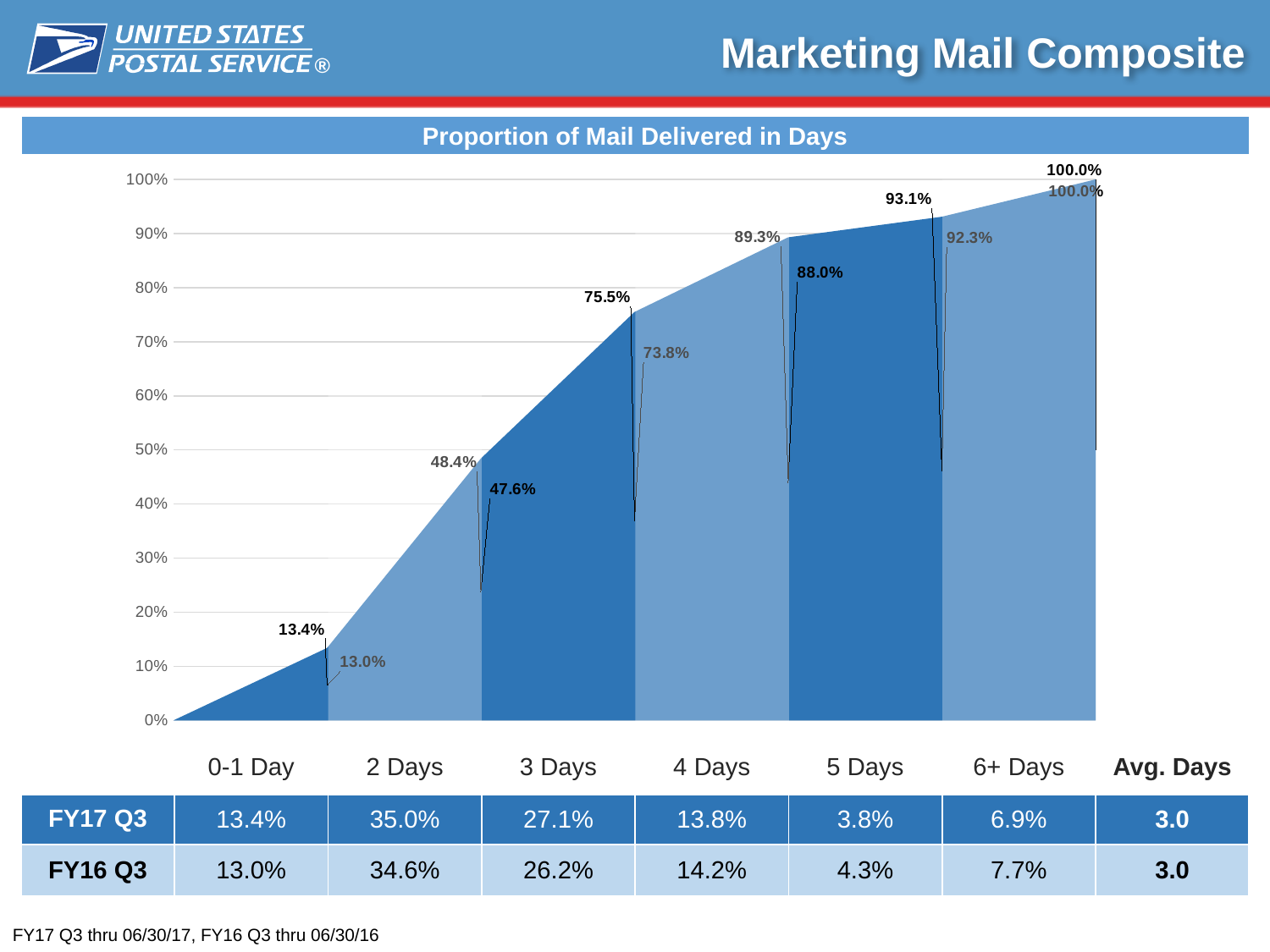
What is the higher of the two values labeled at 3 Days in the chart? 75.5% What value is labeled at 6+ Days in the chart? 100.0% What kind of chart is shown under the title 'Proportion of Mail Delivered in Days'? Area chart What is the difference between the two values labeled at 4 Days (89.3% and 88.0%)? 1.3% What is the title of the chart? Proportion of Mail Delivered in Days What is the higher of the two values labeled at 5 Days in the chart? 93.1% Is the higher value labeled at 2 Days greater or less than 50%? less At which category does the chart reach its highest value? 6+ Days Which is larger at 0-1 Day: the value labeled 13.4% or the value labeled 13.0%? 13.4% Do the plotted values rise or fall from 0-1 Day to 6+ Days? Rise What is the lower of the two values labeled at 2 Days in the chart? 47.6% How many delivery-day categories are shown along the x axis of the chart? 6